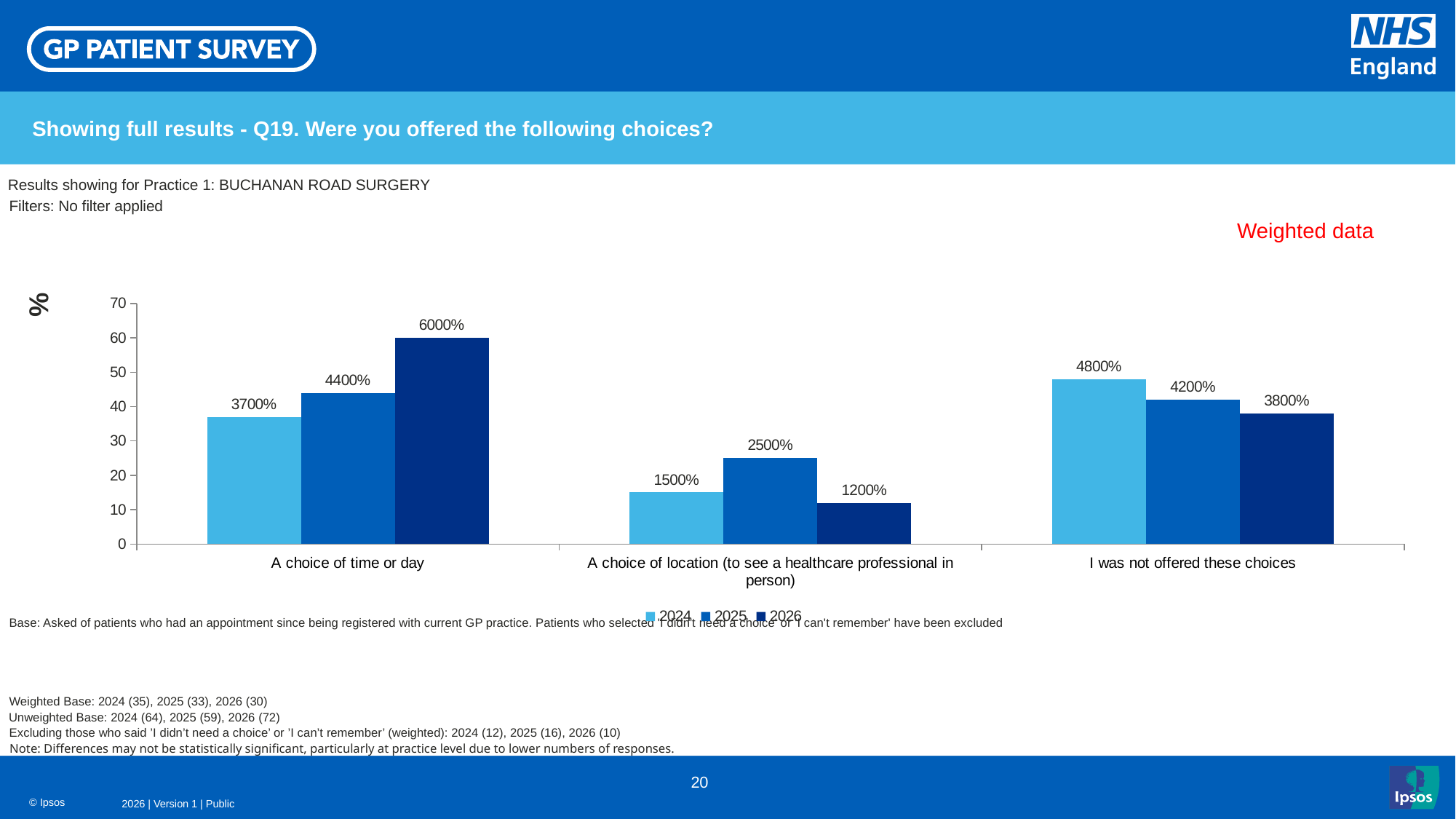
Which year has the lowest bar in the 'A choice of location (to see a healthcare professional in person)' category? 2026 What is the data label for 2025 in the 'A choice of location (to see a healthcare professional in person)' category? 2500% Which year has the highest bar in the 'A choice of time or day' category? 2026 What is the data label for 2026 in the 'A choice of time or day' category? 6000% Which category has the tallest bar overall on the chart? A choice of time or day Is the 2025 bar for 'A choice of time or day' above or below the 40 mark on the axis? above Is the 2024 bar for 'A choice of time or day' larger or smaller than the 2024 bar for 'I was not offered these choices'? smaller What is the data label for 2024 in the 'I was not offered these choices' category? 4800% Do the bars for 'I was not offered these choices' rise or fall from 2024 to 2026? fall How many series does the legend list? 3 What kind of chart is shown on the slide? Bar chart How many categories are shown on the x axis? 3